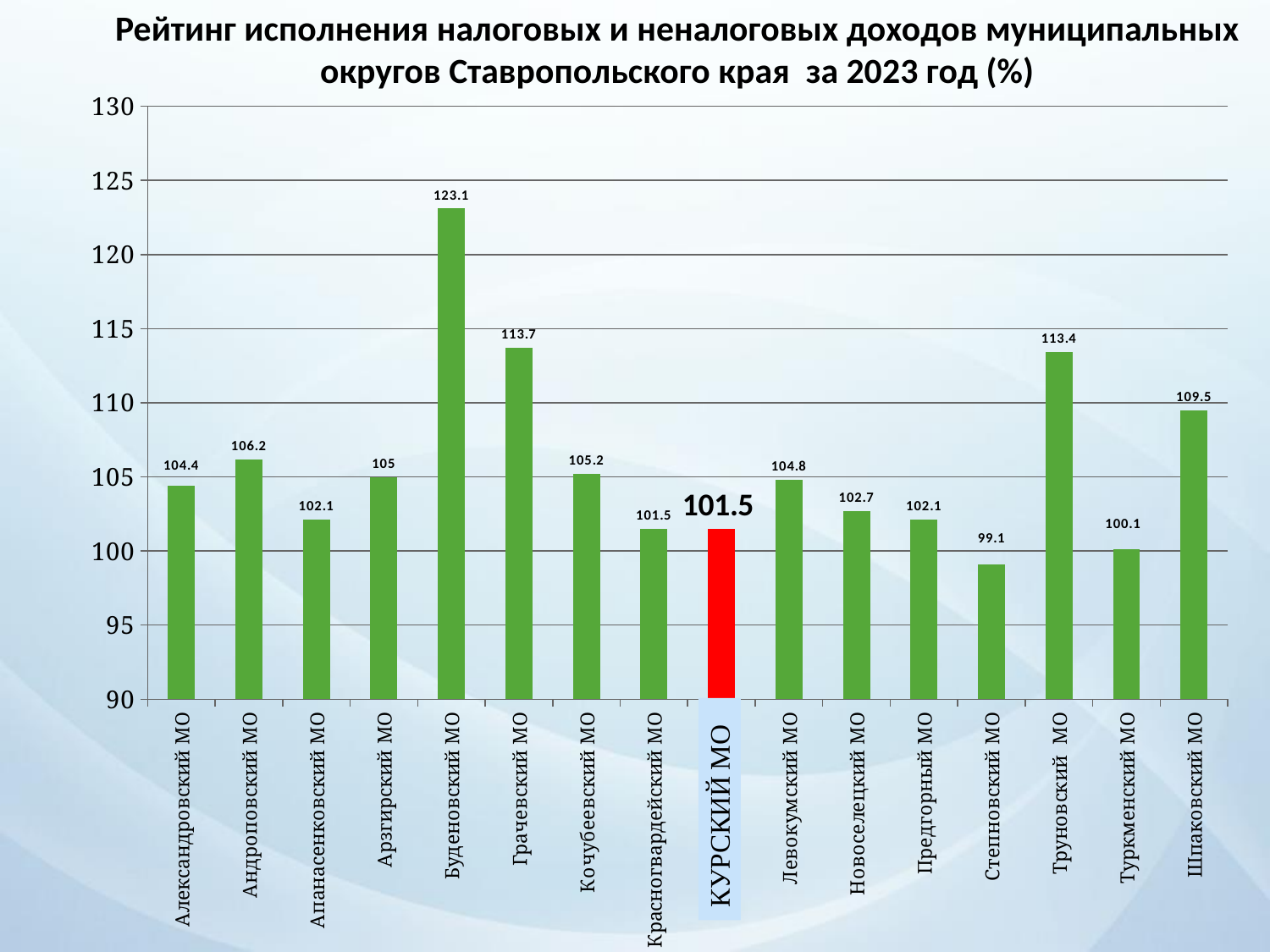
What is the value for КУРСКИЙ МО? 101.5 Which municipal district has the highest value? Буденовский МО What is the value for Шпаковский МО? 109.5 What is the difference between the values for Буденовский МО and Грачевский МО? 9.4 Which is larger, the value for Андроповский МО or the value for Левокумский МО? Андроповский МО Which municipal district has the lowest value? Степновский МО How many municipal districts are shown on the chart? 16 Is the value for Труновский МО greater or less than 110? greater What is the value for Степновский МО? 99.1 Which bar is highlighted in red? КУРСКИЙ МО What is the difference between the values for Шпаковский МО and КУРСКИЙ МО? 8 What is the value for Буденовский МО? 123.1